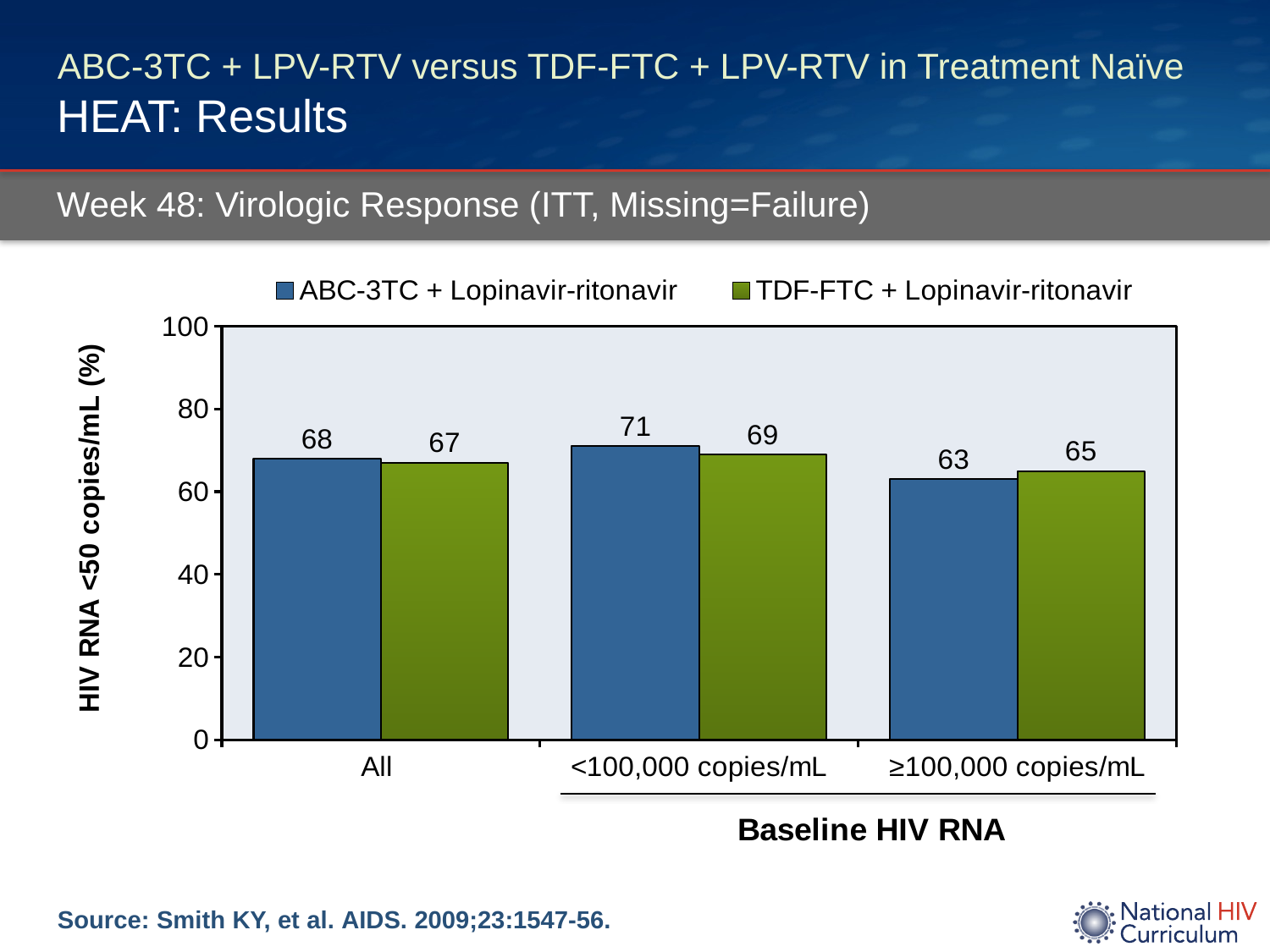
In which category does ABC-3TC + Lopinavir-ritonavir have its lowest value? ≥100,000 copies/mL Is the value for ABC-3TC + Lopinavir-ritonavir in the All category greater or less than 60? greater What is the value for ABC-3TC + Lopinavir-ritonavir in the All category? 68 In which category does ABC-3TC + Lopinavir-ritonavir have its highest value? <100,000 copies/mL In the ≥100,000 copies/mL category, which series has the larger value? TDF-FTC + Lopinavir-ritonavir What kind of chart is shown on the slide? bar chart What is the difference between the ABC-3TC + Lopinavir-ritonavir and TDF-FTC + Lopinavir-ritonavir values in the <100,000 copies/mL category? 2 What is the value for TDF-FTC + Lopinavir-ritonavir in the <100,000 copies/mL category? 69 What is the value for TDF-FTC + Lopinavir-ritonavir in the ≥100,000 copies/mL category? 65 How many series does the legend list? 2 How many categories are shown on the x axis? 3 What is the y-axis label of the chart? HIV RNA <50 copies/mL (%)